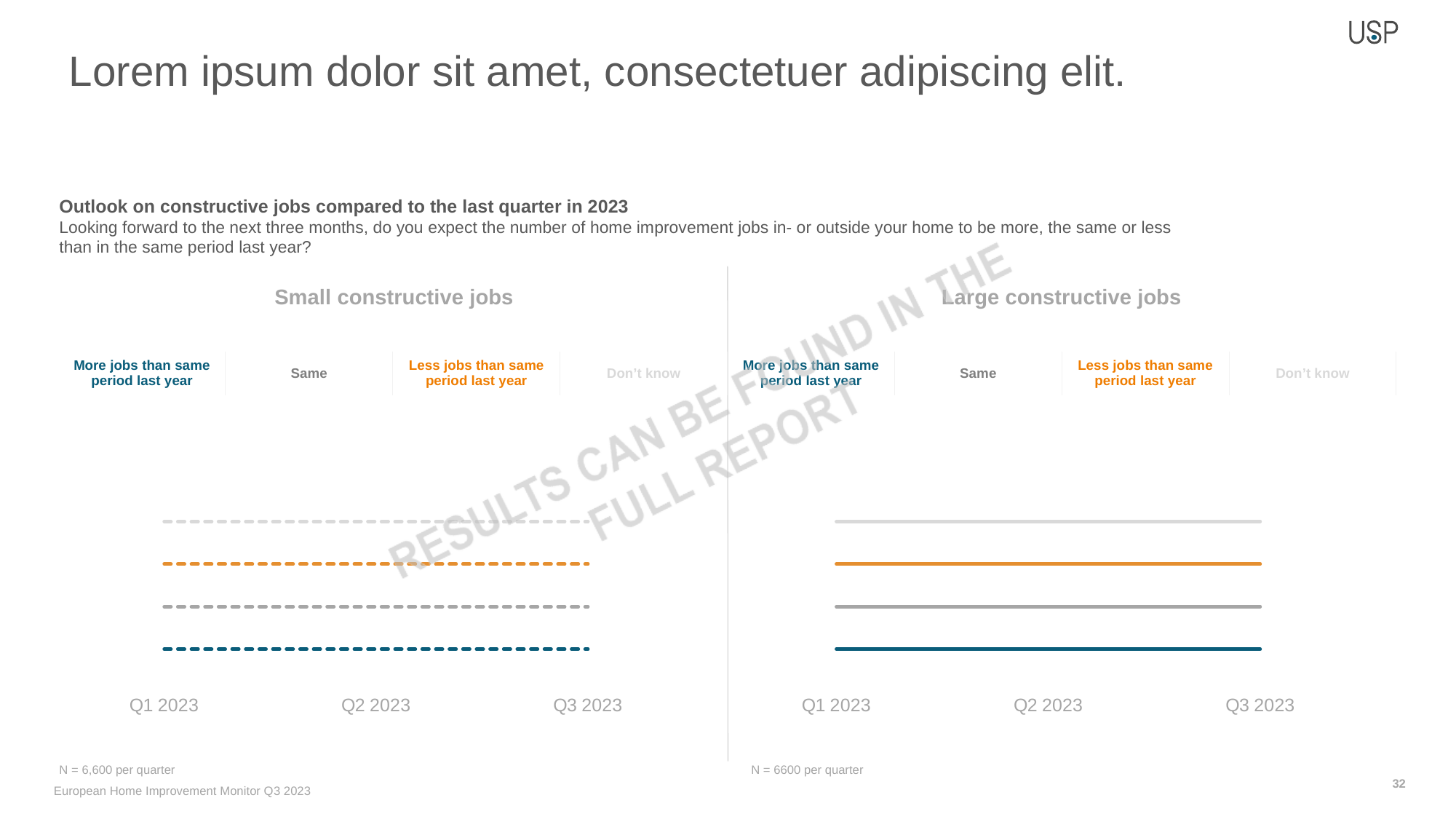
How many series does the legend of the Large constructive jobs chart list? 4 How many quarters are shown on the x axis of the Large constructive jobs chart? 3 In the Small constructive jobs chart, do the lines rise or fall from Q1 2023 to Q3 2023? Neither, they stay flat In the Large constructive jobs chart, which legend entry is shown in orange? Less jobs than same period last year What kind of chart is the Small constructive jobs chart? Line chart In the Large constructive jobs chart, do the lines rise or fall from Q1 2023 to Q3 2023? Neither, they stay flat What is the title of the chart on the left side of the slide? Small constructive jobs What kind of chart is the Large constructive jobs chart? Line chart How many quarters are shown on the x axis of the Small constructive jobs chart? 3 How many series does the legend of the Small constructive jobs chart list? 4